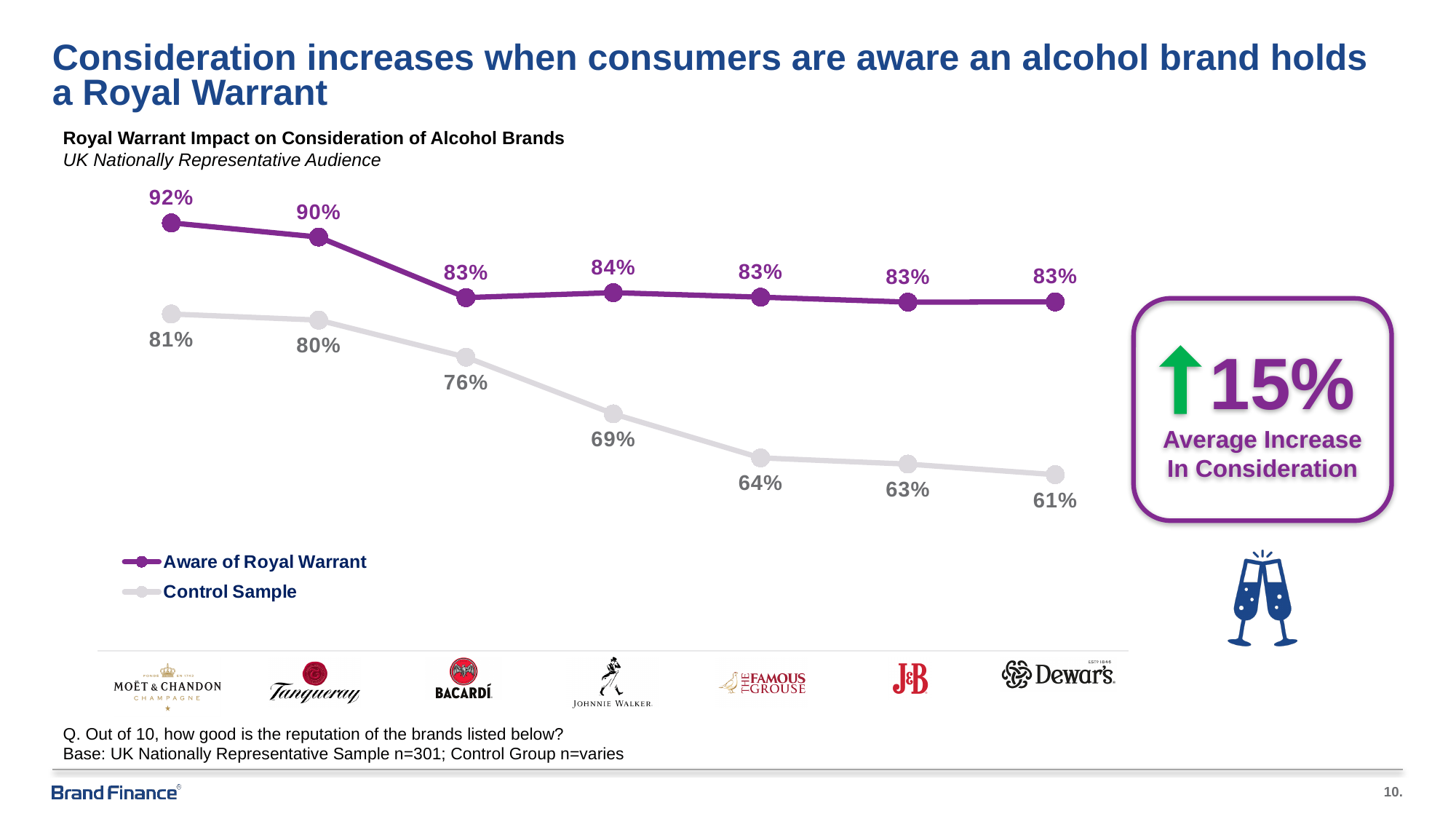
Which is larger for Bacardí: the Aware of Royal Warrant value or the Control Sample value? Aware of Royal Warrant Does the Control Sample series rise or fall from Moët & Chandon to Dewar's? Fall How many brands are plotted along the x axis? 7 How many series does the legend list? 2 What average increase in consideration is highlighted in the box on the right of the chart? 15% Which brand has the lowest Control Sample value? Dewar's Which brand has the highest Aware of Royal Warrant value? Moët & Chandon What type of chart is shown on the slide? Line chart What is the Aware of Royal Warrant value for Moët & Chandon? 92% What is the Control Sample value for Dewar's? 61% What is the difference between the Aware of Royal Warrant and Control Sample values for Dewar's? 22 percentage points What is the Control Sample value for Johnnie Walker? 69%